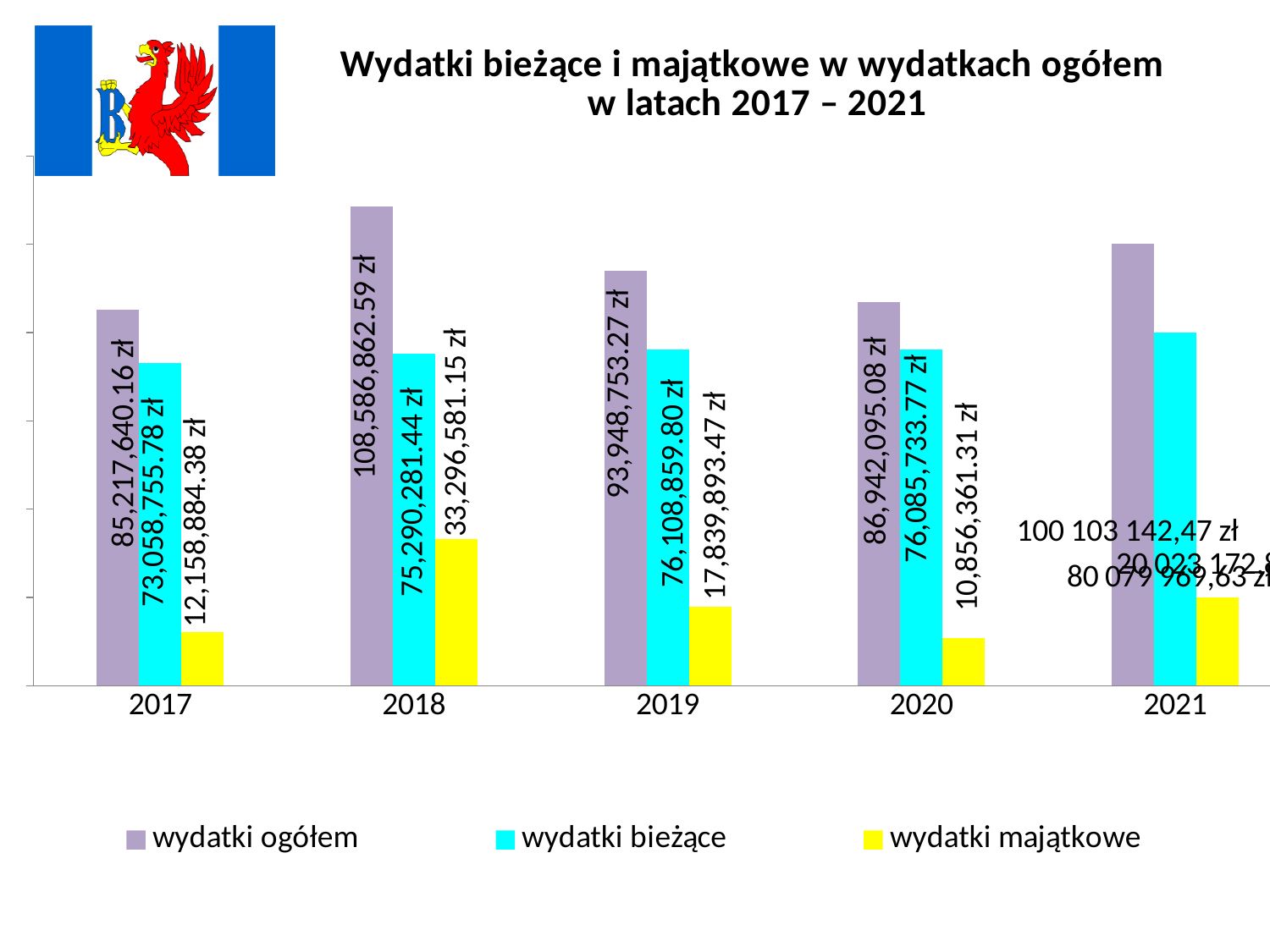
In which year is wydatki majątkowe the lowest? 2020 What is the value of wydatki majątkowe for 2020? 10,856,361.31 zł How many series does the legend list? 3 What kind of chart is shown on the slide? bar chart How many years are shown on the x axis? 5 Which year has the larger wydatki majątkowe, 2017 or 2018? 2018 Does wydatki majątkowe rise or fall from 2018 to 2020? fall What is the difference between wydatki ogółem and wydatki bieżące in 2018? 33,296,581.15 zł What is the value of wydatki ogółem for 2017? 85,217,640.16 zł What is the value of wydatki bieżące for 2018? 75,290,281.44 zł In which year is wydatki ogółem the highest? 2018 What is the value of wydatki majątkowe for 2019? 17,839,893.47 zł